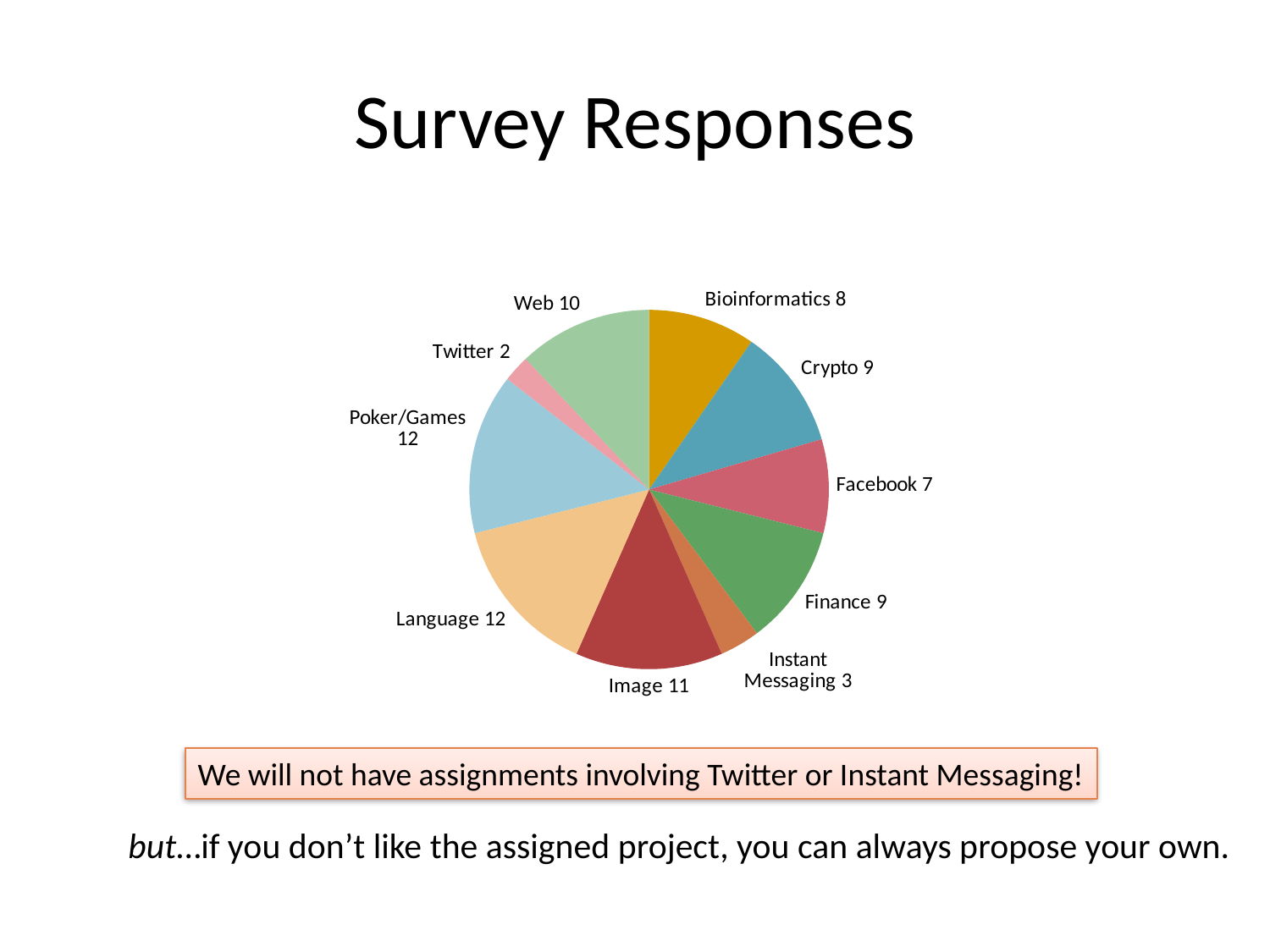
What is the difference between the values for Web and Bioinformatics? 2 What is the title of the chart on the slide? Survey Responses What is the value for Instant Messaging in the pie chart? 3 Which is larger, the value for Image or the value for Instant Messaging? Image How many categories are shown in the pie chart? 10 Which is larger, the value for Finance or the value for Facebook? Finance What kind of chart is shown on the slide? Pie chart What is the value for Crypto in the pie chart? 9 What is the value for Image in the pie chart? 11 What is the difference between the values for Language and Facebook? 5 Which category has the smallest slice in the pie chart? Twitter What is the value for Web in the pie chart? 10